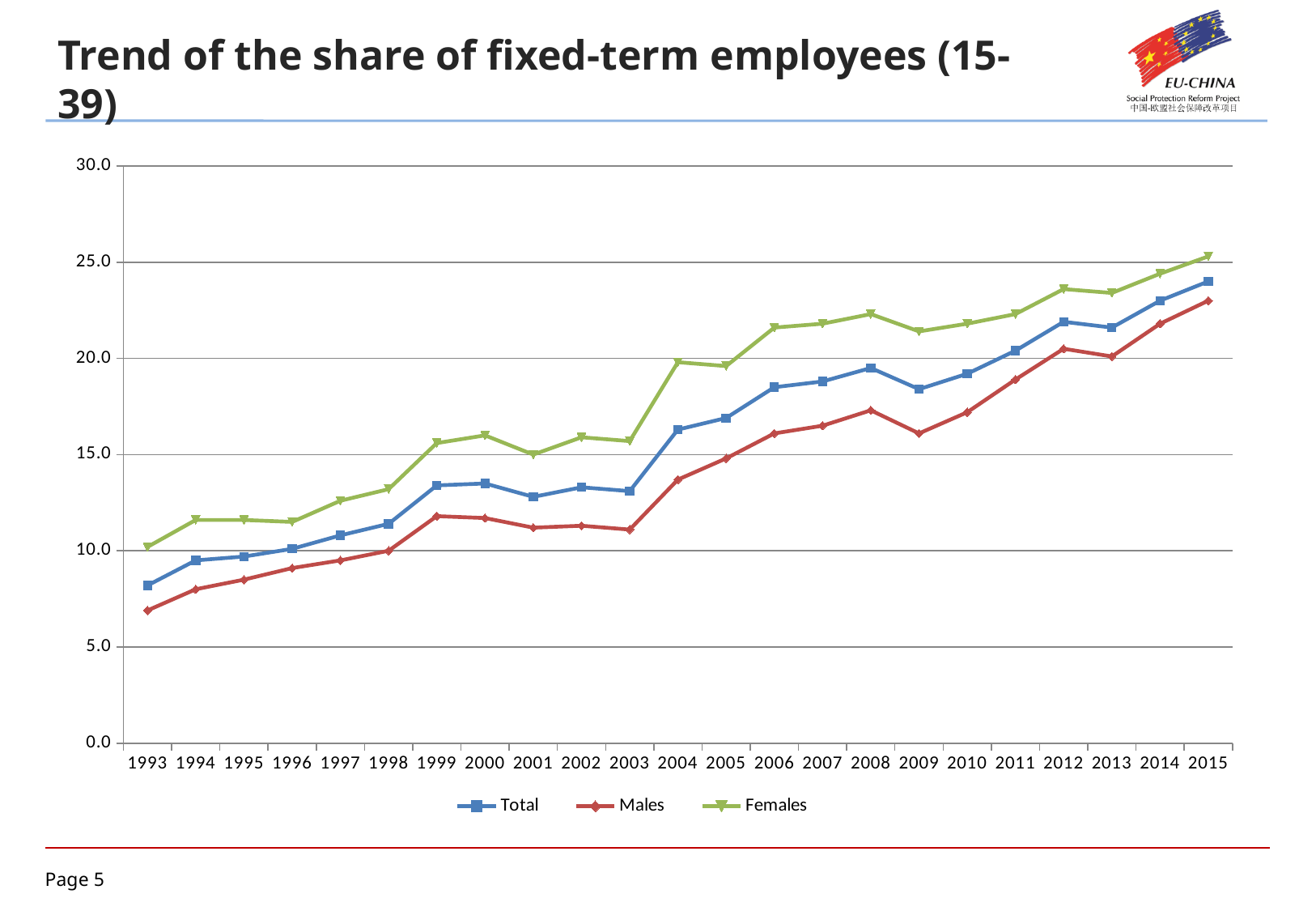
How many series does the legend list? 3 Does the Females series generally rise or fall from 1993 to 2015? Rise For the Total series, which year has the larger value, 2008 or 2009? 2008 Is the Males value for 1993 greater or less than 10.0? less How many years are plotted along the x axis? 23 In which year does the Females series reach its highest value? 2015 What kind of chart is shown on the slide? Line chart Is the Females value for 2004 greater or less than 15.0? greater Is the Total value for 2015 greater or less than 25.0? less Which series does the legend list: name them in order. Total, Males, Females In 2015, which is larger, the Females value or the Males value? Females In which year is the Males series at its lowest value? 1993